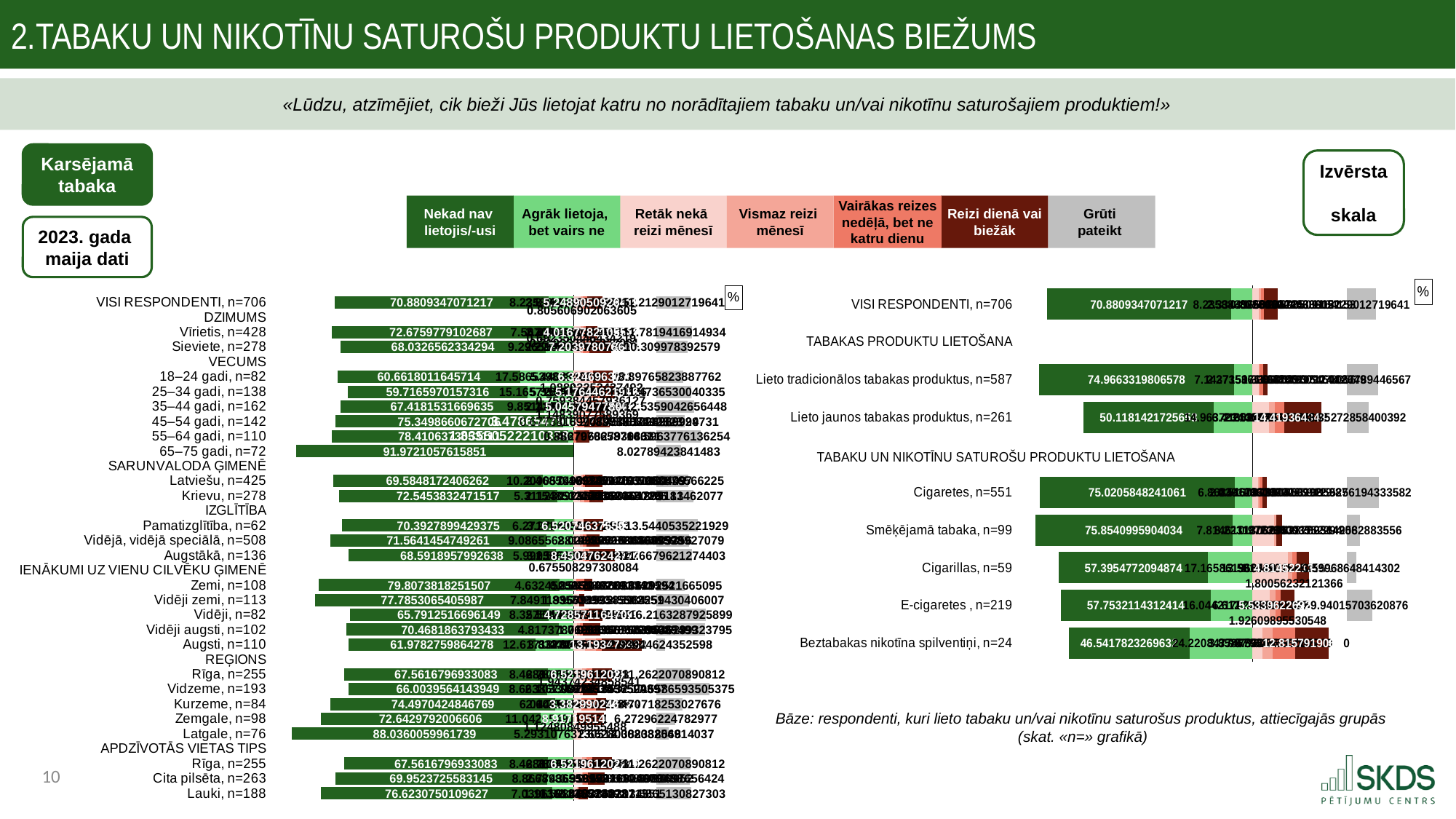
In the left chart, which has the larger 'Nekad nav lietojis/-usi' value: Vīrietis, n=428 or Sieviete, n=278? Vīrietis, n=428 In the right chart, which group has the lowest 'Nekad nav lietojis/-usi' value? Beztabakas nikotīna spilventiņi, n=24 In the left chart, what is the difference between the 'Nekad nav lietojis/-usi' values for Vīrietis, n=428 and Sieviete, n=278? 4.6433216768393 In the left chart, what is the 'Nekad nav lietojis/-usi' value for 65–75 gadi, n=72? 91.9721057615851 In the left chart, what is the 'Nekad nav lietojis/-usi' value for Latgale, n=76? 88.0360059961739 In the right chart, what is the 'Nekad nav lietojis/-usi' value for Cigaretes, n=551? 75.0205848241061 In the left chart, what is the value of the 'Nekad nav lietojis/-usi' segment for VISI RESPONDENTI, n=706? 70.8809347071217 How many response categories does the legend list? 7 In the left chart, how many regions are listed under REĢIONS? 5 In the left chart, which age group (VECUMS) has the highest 'Nekad nav lietojis/-usi' value? 65–75 gadi, n=72 In the right chart, what is the 'Nekad nav lietojis/-usi' value for Lieto tradicionālos tabakas produktus, n=587? 74.9663319806578 What type of chart is used on this slide? Stacked bar chart